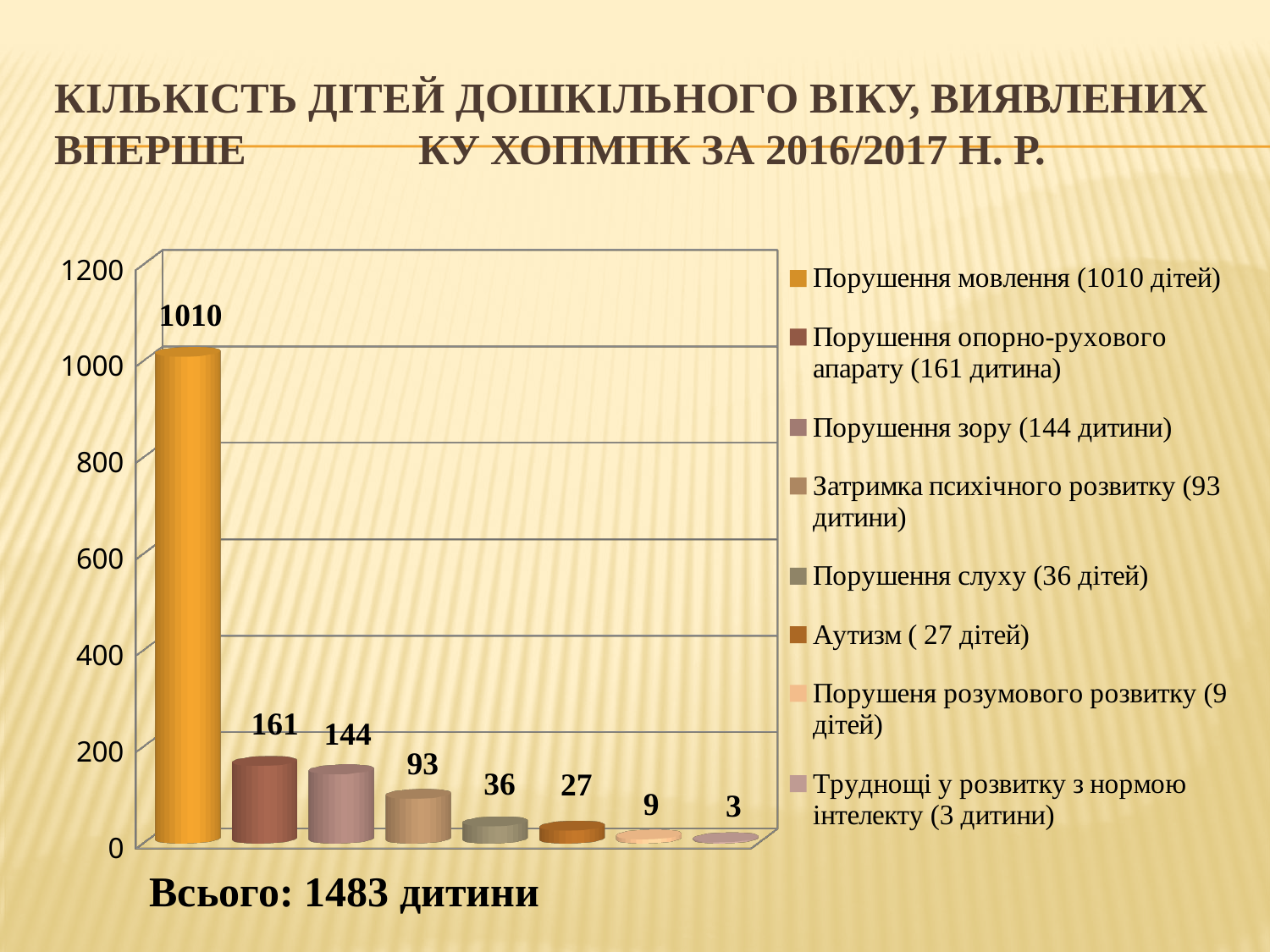
What total number of children is stated below the chart? 1483 What kind of chart is shown on the slide? bar chart How many entries does the legend list? 8 What is the value for Аутизм? 27 What is the value for Порушення мовлення? 1010 How many bars are plotted in the chart? 8 Which category has the lowest value? Труднощі у розвитку з нормою інтелекту What is the value for Порушення зору? 144 What is the difference between the values for Порушення опорно-рухового апарату and Порушення зору? 17 What is the value for Затримка психічного розвитку? 93 Which category has the highest value? Порушення мовлення Which is larger, the value for Порушення слуху or the value for Аутизм? Порушення слуху